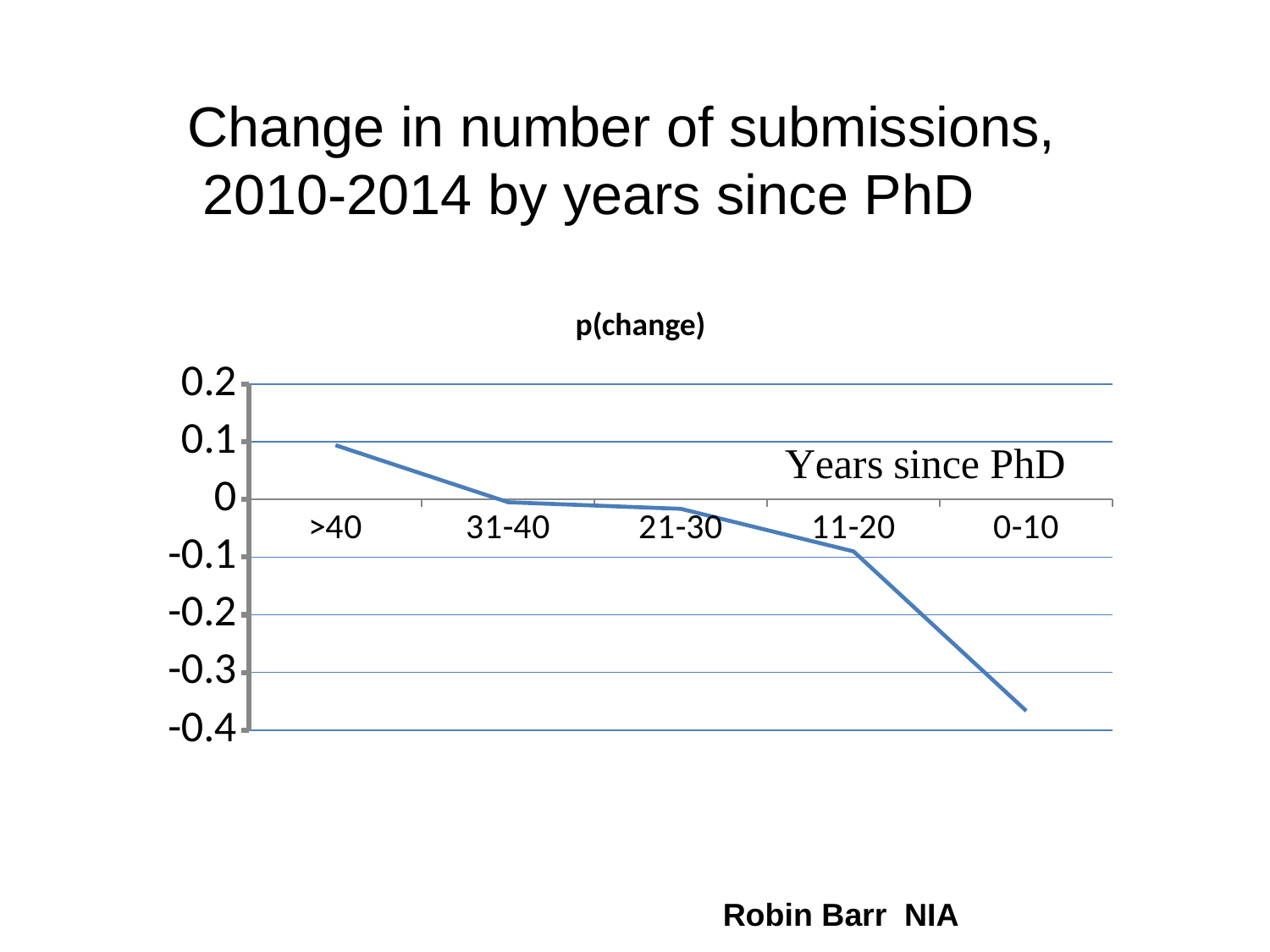
What is the title shown above the chart? p(change) Is the value for 11-20 greater or less than 0? less Which is larger, the value for >40 or the value for 31-40? >40 Which is larger, the value for 11-20 or the value for 0-10? 11-20 Is the value for >40 greater or less than 0? greater Which category has the lowest value in the chart? 0-10 Do the values rise or fall moving along the x axis from >40 to 0-10? fall Is the value for >40 greater or less than 0.2? less How many categories are plotted along the x axis of the chart? 5 What kind of chart is shown on the slide? line chart Which category has the highest value in the chart? >40